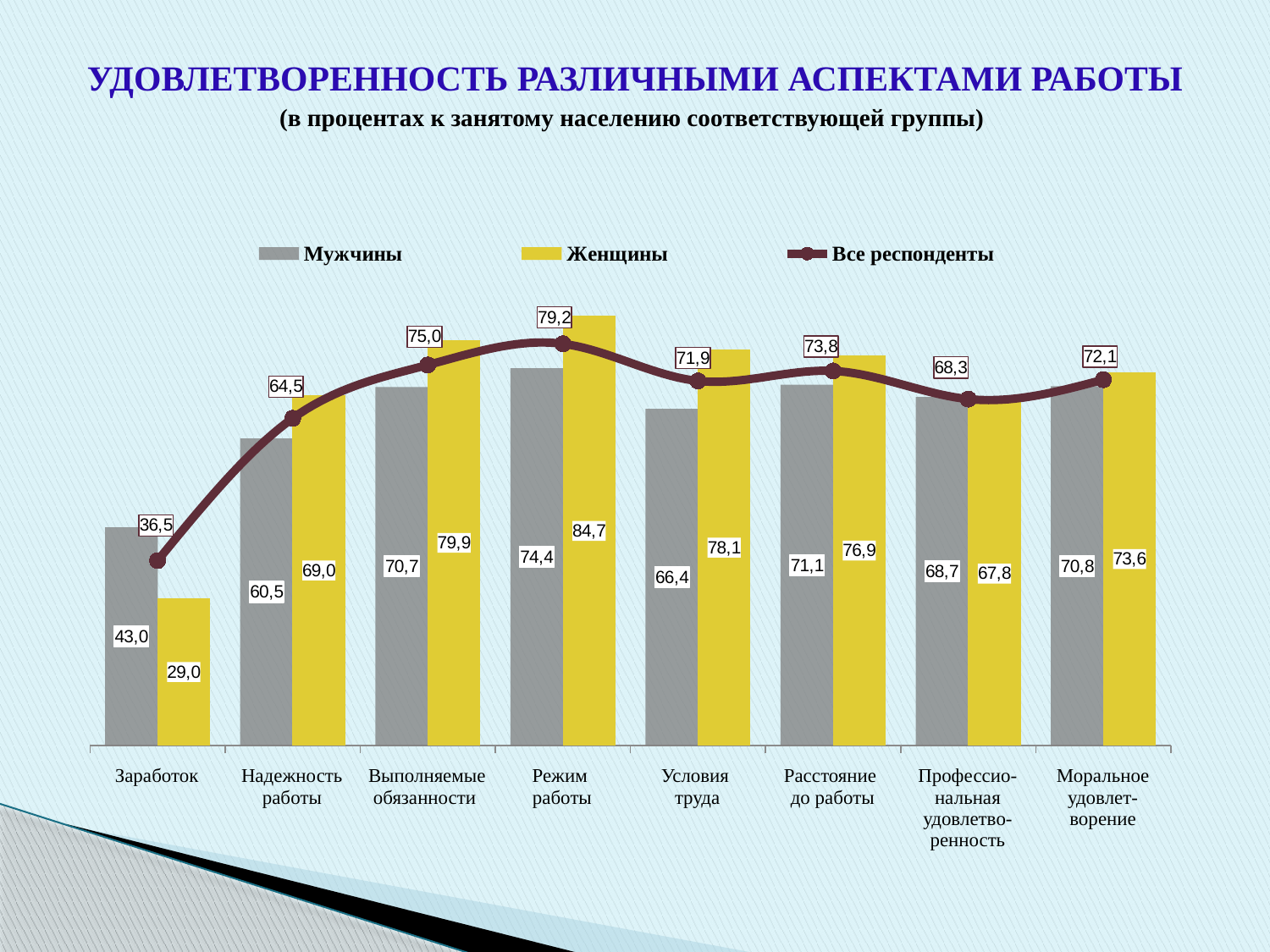
How many series does the legend list? 3 What is the value for Мужчины in the Заработок category? 43,0 Does the Все респонденты line rise or fall from Заработок to Режим работы? Rise In which category is the Женщины value highest? Режим работы How many categories are shown on the x axis? 8 What is the difference between the Мужчины and Женщины values for Заработок? 14,0 For Профессиональная удовлетворенность, which is larger: the Мужчины value or the Женщины value? Мужчины What is the value for Женщины in the Режим работы category? 84,7 In which category is the Мужчины value lowest? Заработок What is the value of the Все респонденты line for Условия труда? 71,9 What kind of chart is this? Bar chart with a line series What is the difference between the Женщины and Мужчины values for Режим работы? 10,3